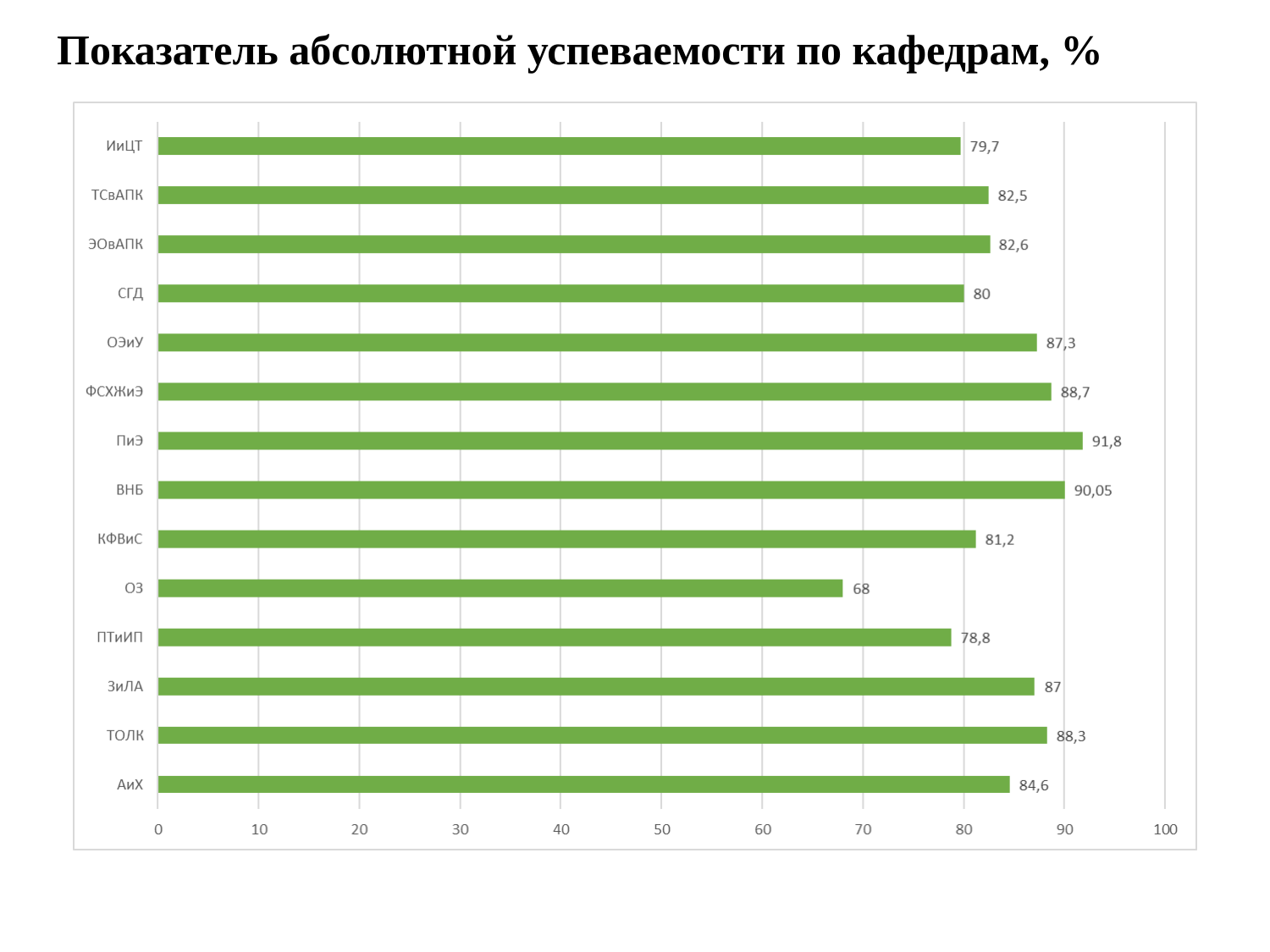
Which is larger, the value for ТОЛК or the value for ОЭиУ? ТОЛК What kind of chart is shown on the slide? bar chart What is the difference between the values for ПиЭ and ОЗ? 23,8 What is the value for ВНБ? 90,05 What is the value for ПиЭ? 91,8 How many departments are shown in the chart? 14 Is the value for ОЗ greater or less than 70? less What is the value for АиХ? 84,6 Which department has the lowest value? ОЗ Which department has the highest value? ПиЭ What is the title of the slide? Показатель абсолютной успеваемости по кафедрам, % What is the value for ОЗ? 68